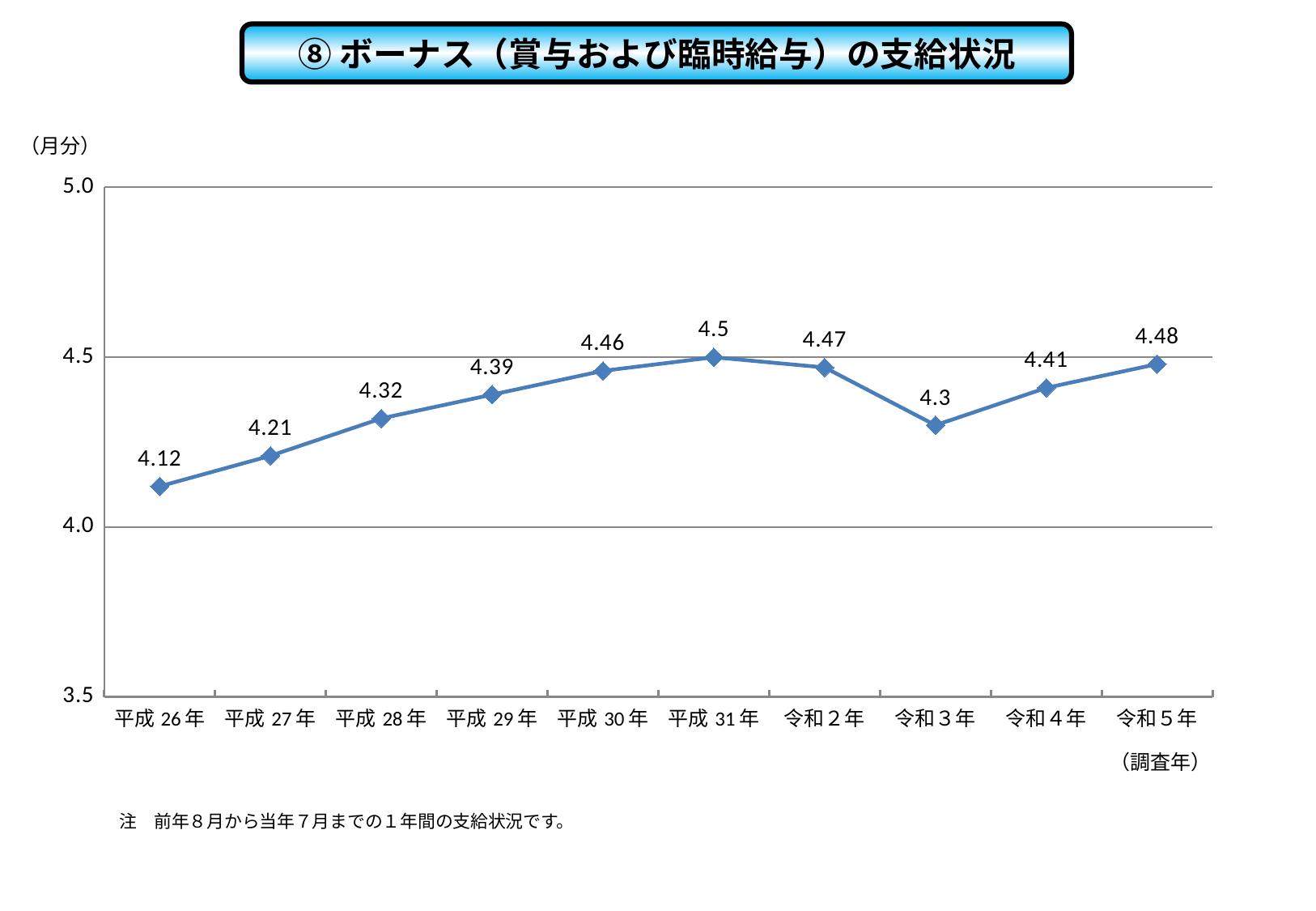
Which year has the lowest value? 平成26年 What is the value for 令和3年? 4.3 How many years are plotted on the x axis? 10 What unit is shown above the y axis? 月分 What kind of chart is shown? line chart Is the value for 平成28年 greater or less than 4.5? less What is the value for 平成26年? 4.12 Which is larger, the value for 令和2年 or the value for 令和4年? 令和2年 Which year has the highest value? 平成31年 What is the difference between the values for 平成31年 and 令和3年? 0.2 What is the value for 令和5年? 4.48 Do the values rise or fall from 平成26年 to 平成31年? rise